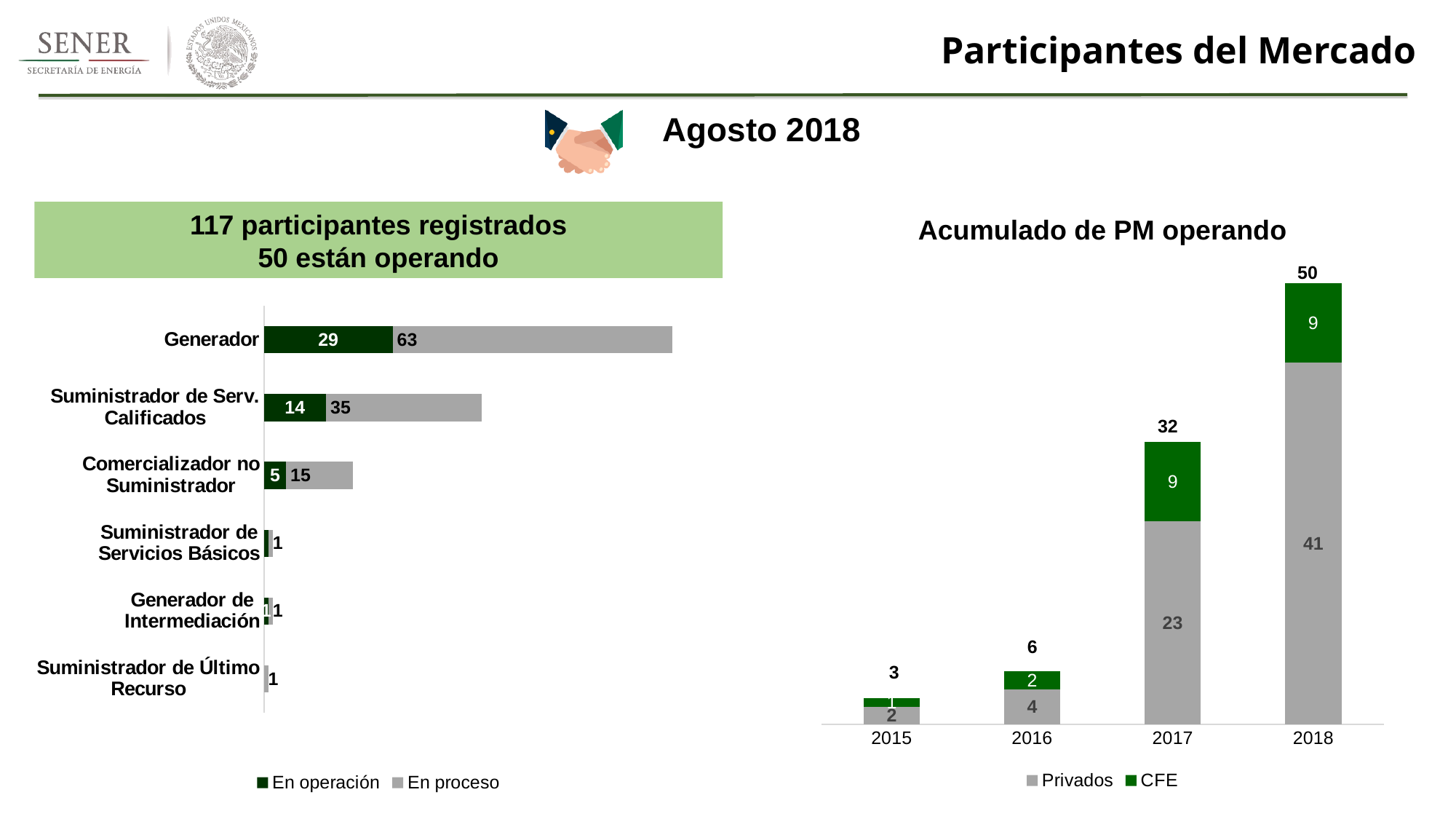
In the left chart, what is the difference between the 'En proceso' and 'En operación' values for Generador? 34 In the left chart, how many Generador participants are 'En proceso'? 63 In the chart 'Acumulado de PM operando', how many series does the legend list? 2 In the chart 'Acumulado de PM operando', do the totals rise or fall from 2015 to 2018? rise In the chart 'Acumulado de PM operando', what is the Privados value for 2017? 23 In the left chart, which category has the highest 'En operación' value? Generador In the left chart, how many categories are shown? 6 In the chart 'Acumulado de PM operando', what is the CFE value for 2016? 2 In the left chart, what is the 'En proceso' value for Suministrador de Serv. Calificados? 35 In the chart 'Acumulado de PM operando', what is the total for 2018? 50 In the left chart, what is the 'En operación' value for Comercializador no Suministrador? 5 In the left chart, how many Generador participants are 'En operación'? 29